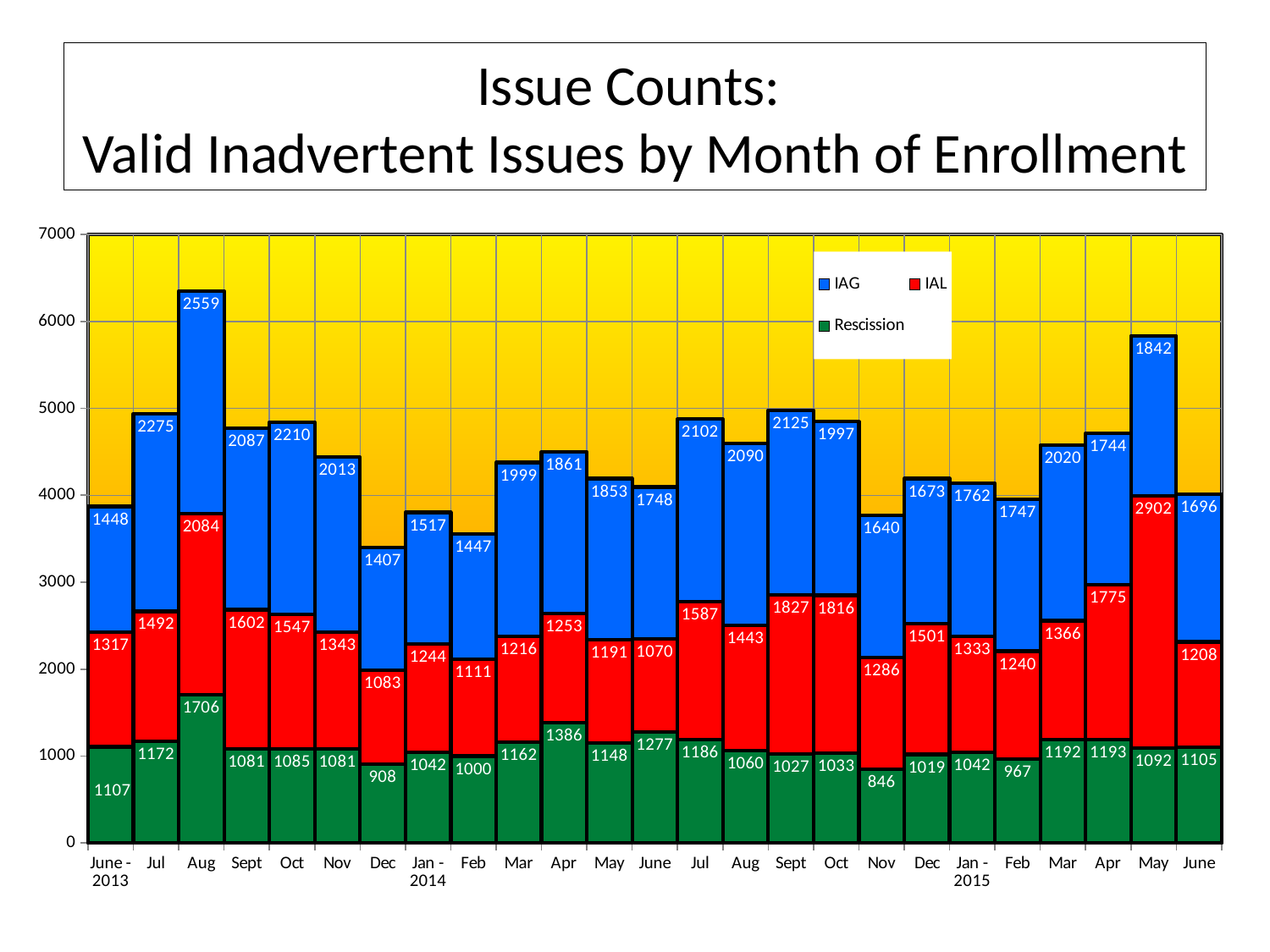
How many series does the legend list? 3 Which month has the highest IAG value? Aug 2013 What is the Rescission value for Nov 2014? 846 What is the total of the stacked bar for Aug 2013? 6349 What is the difference between the IAL values for Aug 2013 and Sept 2013? 482 How many months are shown on the x axis? 25 What is the IAL value for May 2015? 2902 Which is larger, the IAG value for Jul 2014 or the IAG value for Aug 2014? Jul 2014 What kind of chart is shown on the slide? Stacked bar chart What is the IAG value for Aug 2013? 2559 Which month has the lowest Rescission value? Nov 2014 What is the total of the stacked bar for June 2013? 3872